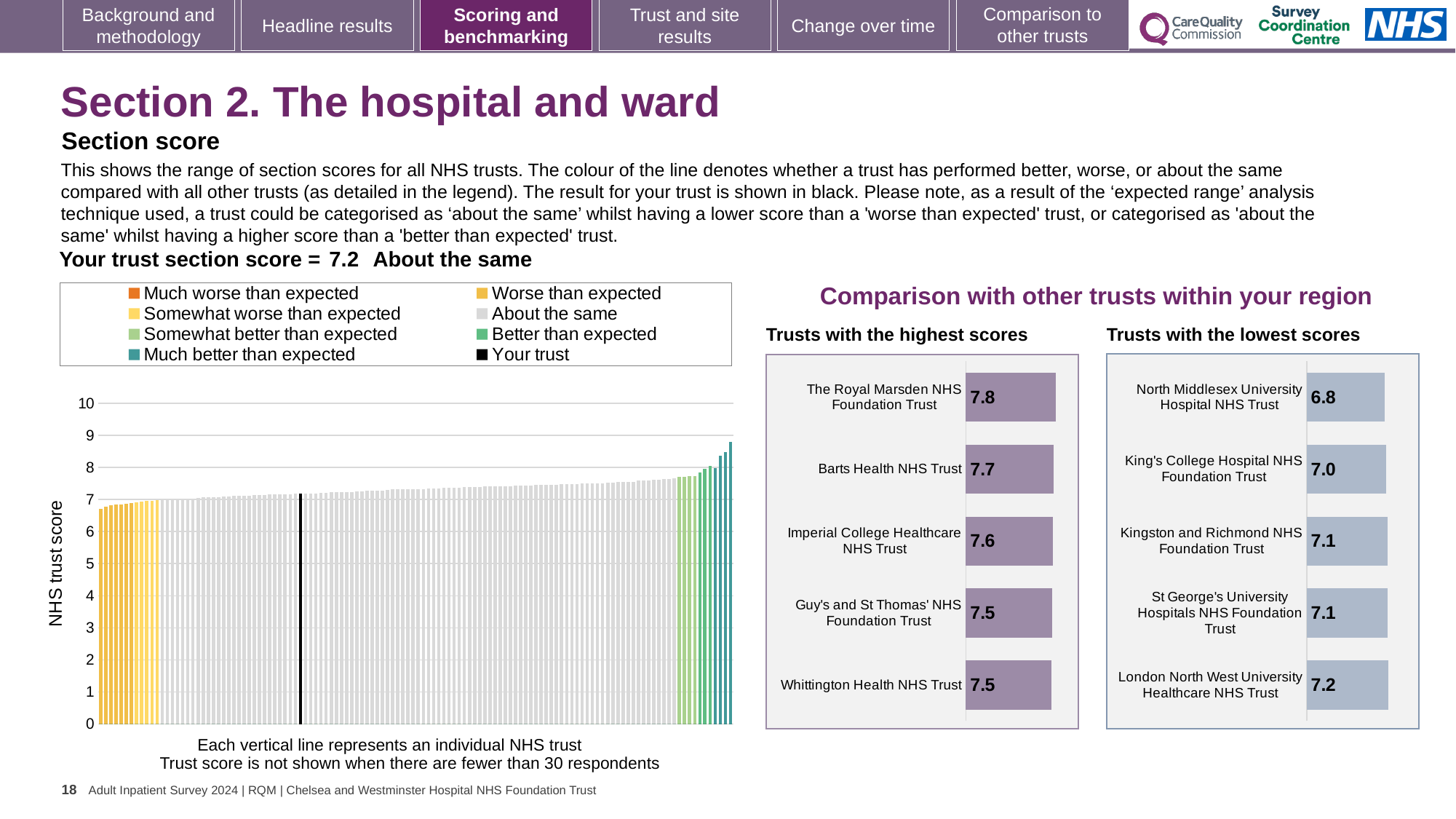
How many entries does the legend of the large chart on the left list? 8 In the 'Trusts with the lowest scores' chart, which trust has the lowest score? North Middlesex University Hospital NHS Trust In the 'Trusts with the highest scores' chart, what is the score for The Royal Marsden NHS Foundation Trust? 7.8 In the 'Trusts with the highest scores' chart, what is the score for Imperial College Healthcare NHS Trust? 7.6 In the 'Trusts with the lowest scores' chart, what is the score for North Middlesex University Hospital NHS Trust? 6.8 In the 'Trusts with the lowest scores' chart, what is the difference between the scores of London North West University Healthcare NHS Trust and North Middlesex University Hospital NHS Trust? 0.4 What kind of chart is the large chart on the left showing NHS trust scores? Bar chart In the 'Trusts with the lowest scores' chart, what is the score for London North West University Healthcare NHS Trust? 7.2 In the 'Trusts with the highest scores' chart, how many trusts are shown? 5 In the 'Trusts with the highest scores' chart, which trust has the highest score? The Royal Marsden NHS Foundation Trust In the 'Trusts with the lowest scores' chart, which has the larger score: King's College Hospital NHS Foundation Trust or Kingston and Richmond NHS Foundation Trust? Kingston and Richmond NHS Foundation Trust In the 'Trusts with the highest scores' chart, what is the difference between the scores of The Royal Marsden NHS Foundation Trust and Whittington Health NHS Trust? 0.3